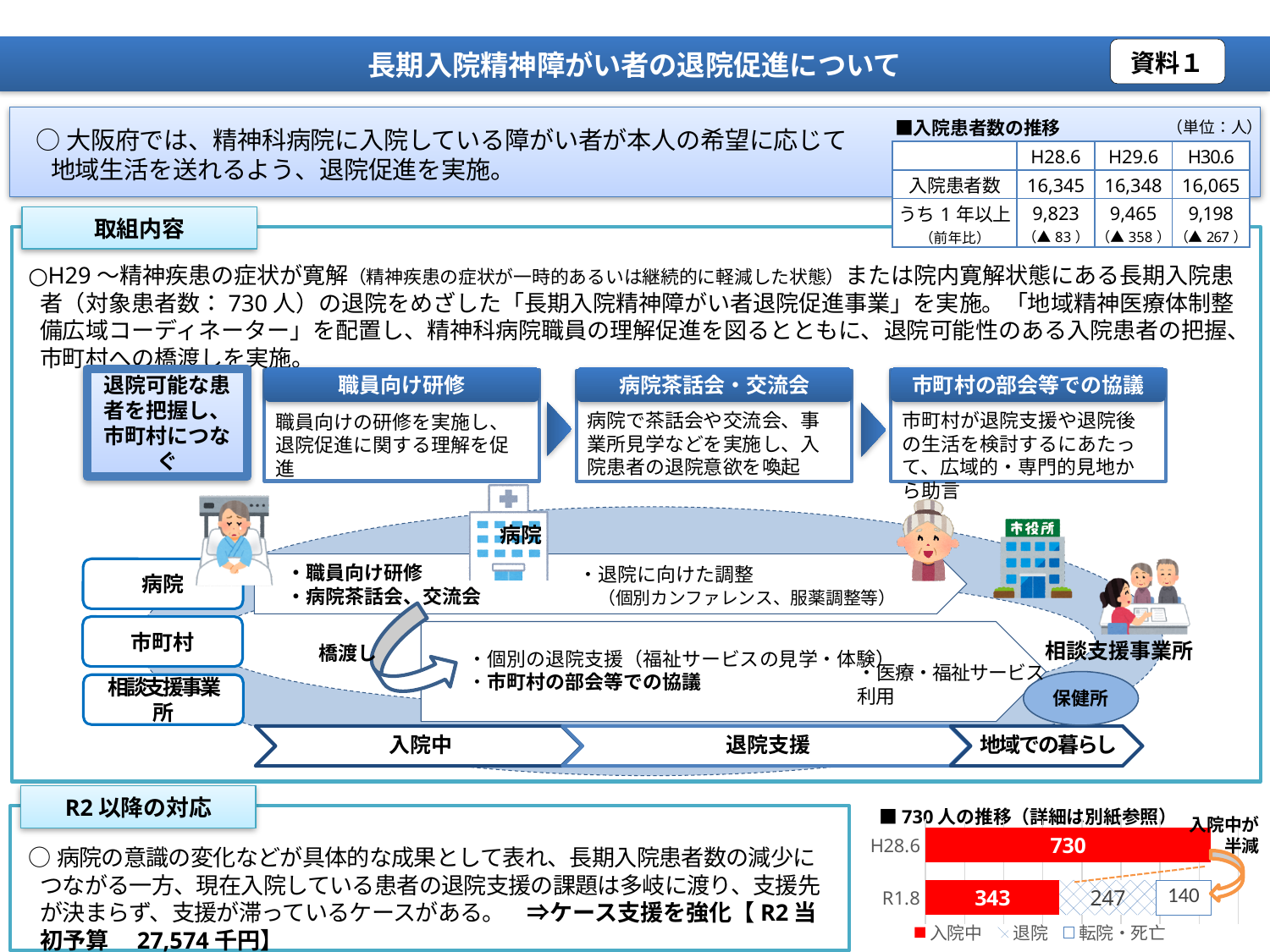
In the "730人の推移" chart, what is the difference between the 入院中 value for H28.6 and the 入院中 value for R1.8? 387 In the "730人の推移" chart, what is the value of 転院・死亡 for R1.8? 140 In the "730人の推移" chart, what is the total of the stacked bar for R1.8? 730 In the "730人の推移" chart, what is the value of 入院中 for H28.6? 730 In the "730人の推移" chart, which segment of the R1.8 bar is the largest? 入院中 In the "730人の推移" chart, which segment of the R1.8 bar is the smallest? 転院・死亡 What kind of chart is the "730人の推移" chart at the bottom right of the slide? bar chart In the "730人の推移" chart, what is the value of 入院中 for R1.8? 343 How many series does the legend of the "730人の推移" chart list? 3 In the "730人の推移" chart, what is the value of 退院 for R1.8? 247 In the "730人の推移" chart, what colour is used for the 入院中 series? red How many categories (time points) are shown on the "730人の推移" chart? 2